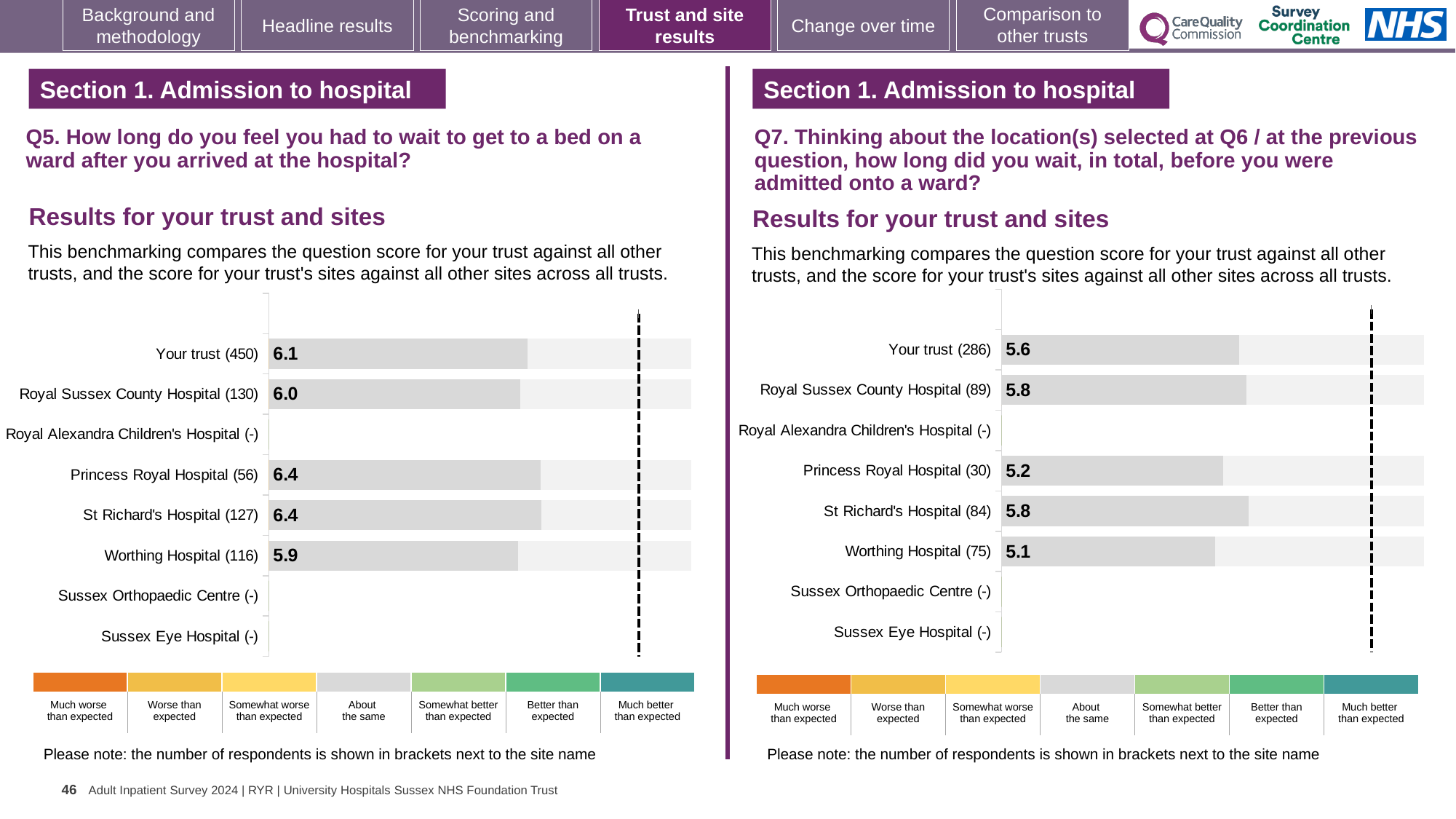
On the Q7 chart on the right, which is larger: the score for Royal Sussex County Hospital or the score for Worthing Hospital? Royal Sussex County Hospital On the Q7 chart on the right, what is the score for Your trust (286)? 5.6 On the Q7 chart on the right, how many respondents are shown in brackets for St Richard's Hospital? 84 On the Q7 chart on the right, what is the score for Princess Royal Hospital (30)? 5.2 On the Q5 chart on the left, what is the difference between the scores for Princess Royal Hospital and Royal Sussex County Hospital? 0.4 On the Q5 chart on the left, what is the score for Worthing Hospital (116)? 5.9 On the Q5 chart on the left, which site has the lowest score? Worthing Hospital On the Q5 chart on the left, how many sites or rows are listed on the vertical axis? 8 On the Q7 chart on the right, what is the difference between the scores for St Richard's Hospital and Your trust? 0.2 What kind of chart is used on the Q5 chart on the left? Bar chart On the Q5 chart on the left, what is the score for Your trust (450)? 6.1 On the Q7 chart on the right, which site has the lowest score? Worthing Hospital